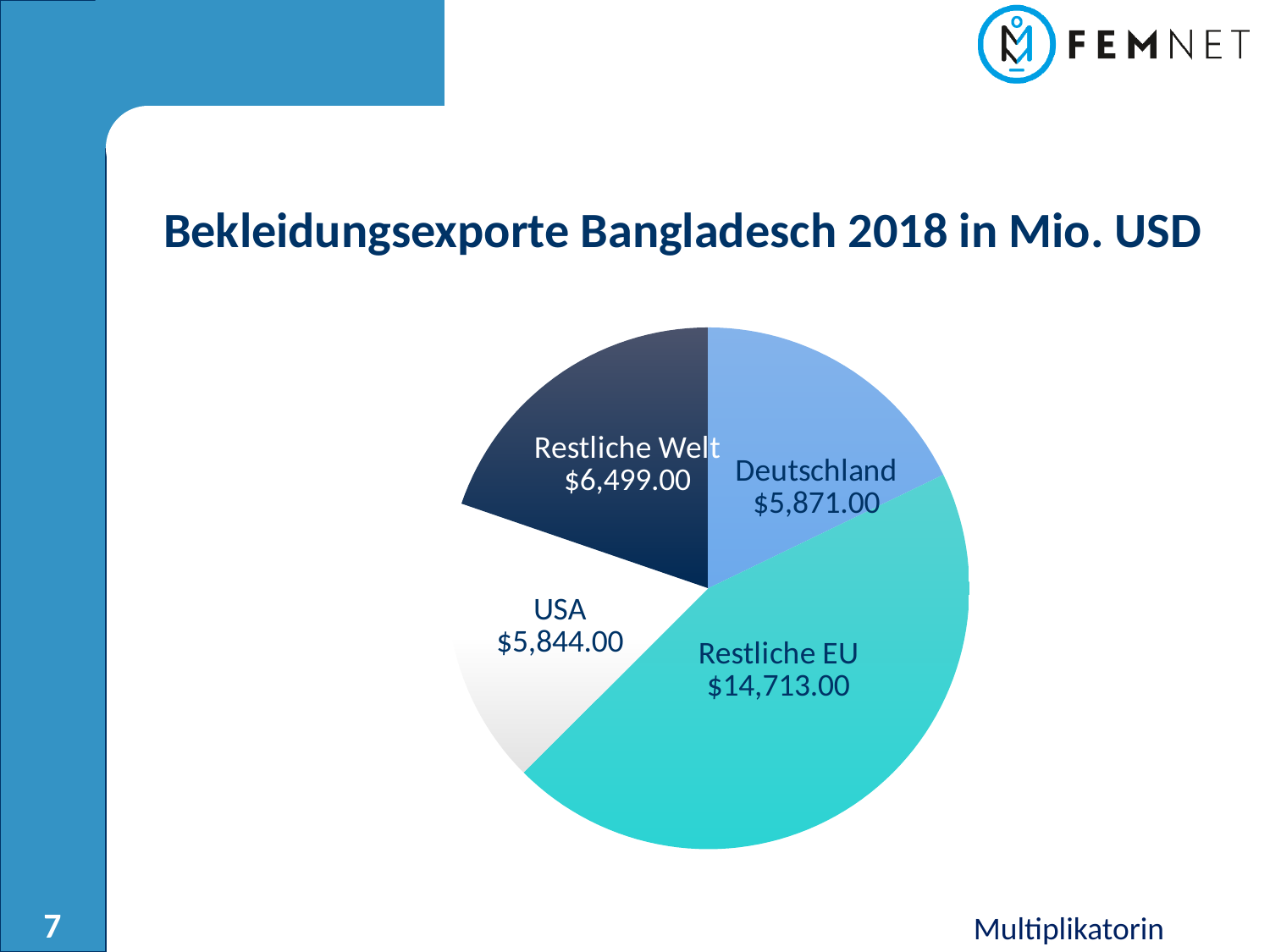
What kind of chart is shown on the slide? Pie chart Which category has the smallest value? USA What is the value for Deutschland? $5,871.00 What is the title of the chart? Bekleidungsexporte Bangladesch 2018 in Mio. USD What is the difference between Restliche Welt and USA? $655.00 What is the value for Restliche Welt? $6,499.00 What is the value for USA? $5,844.00 What is the difference between Restliche EU and Deutschland? $8,842.00 Which is larger, Restliche Welt or Deutschland? Restliche Welt Which category has the largest slice? Restliche EU How many slices does the pie chart have? 4 What is the value for Restliche EU? $14,713.00